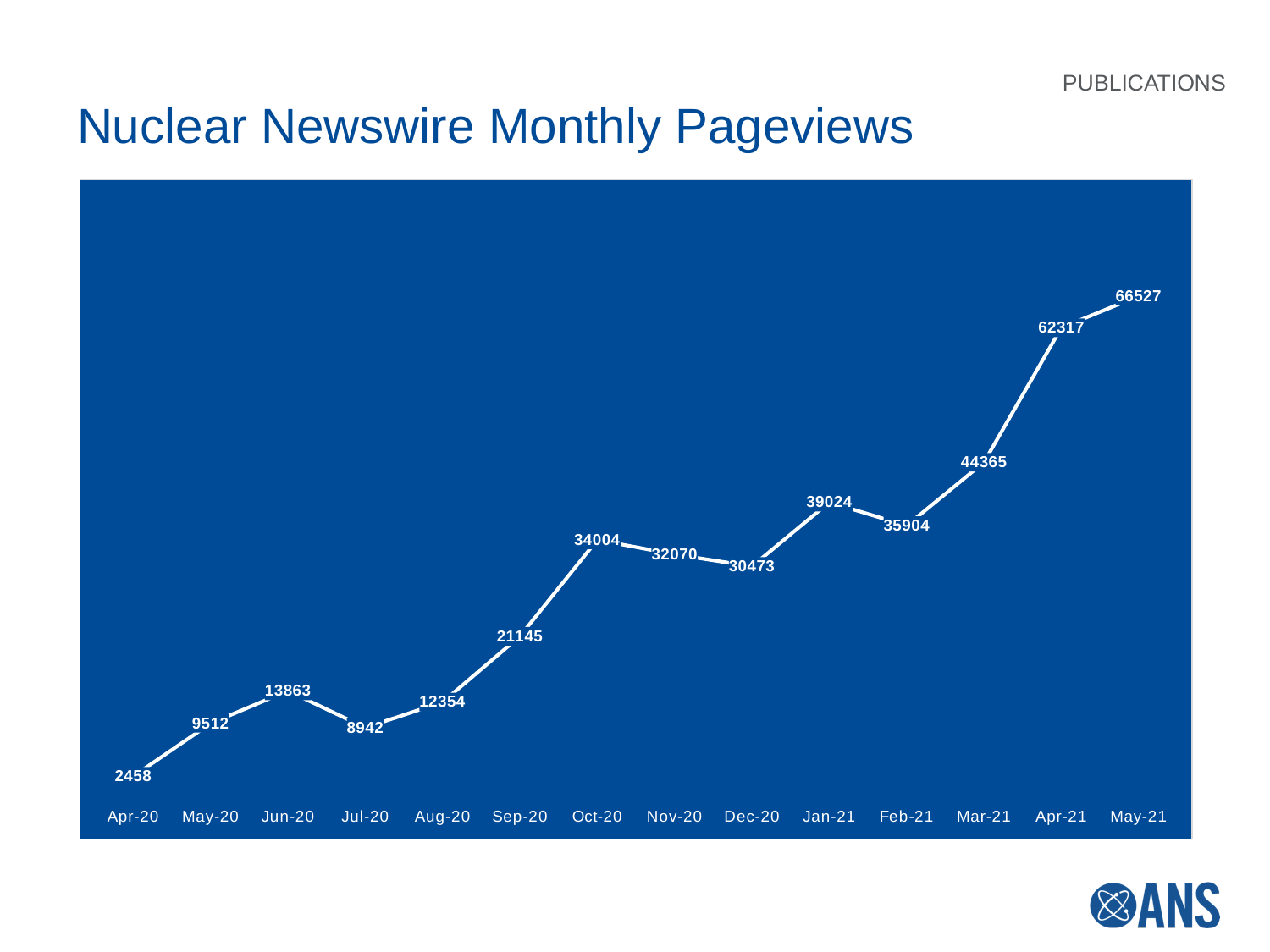
What is the difference between the values for Oct-20 and Sep-20? 12859 How many months are plotted in the chart? 14 Which is larger, the value for Nov-20 or the value for Dec-20? Nov-20 What kind of chart is shown on the slide? line chart Which is larger, the value for Jun-20 or the value for Jul-20? Jun-20 Which month has the highest pageviews in the chart? May-21 What is the difference between the values for May-21 and Apr-21? 4210 What is the value for Apr-20 in the chart? 2458 Do the pageviews generally rise or fall from Apr-20 to May-21? rise What is the value for Oct-20 in the Nuclear Newswire Monthly Pageviews chart? 34004 What is the value for Feb-21 in the chart? 35904 Which month has the lowest pageviews in the chart? Apr-20